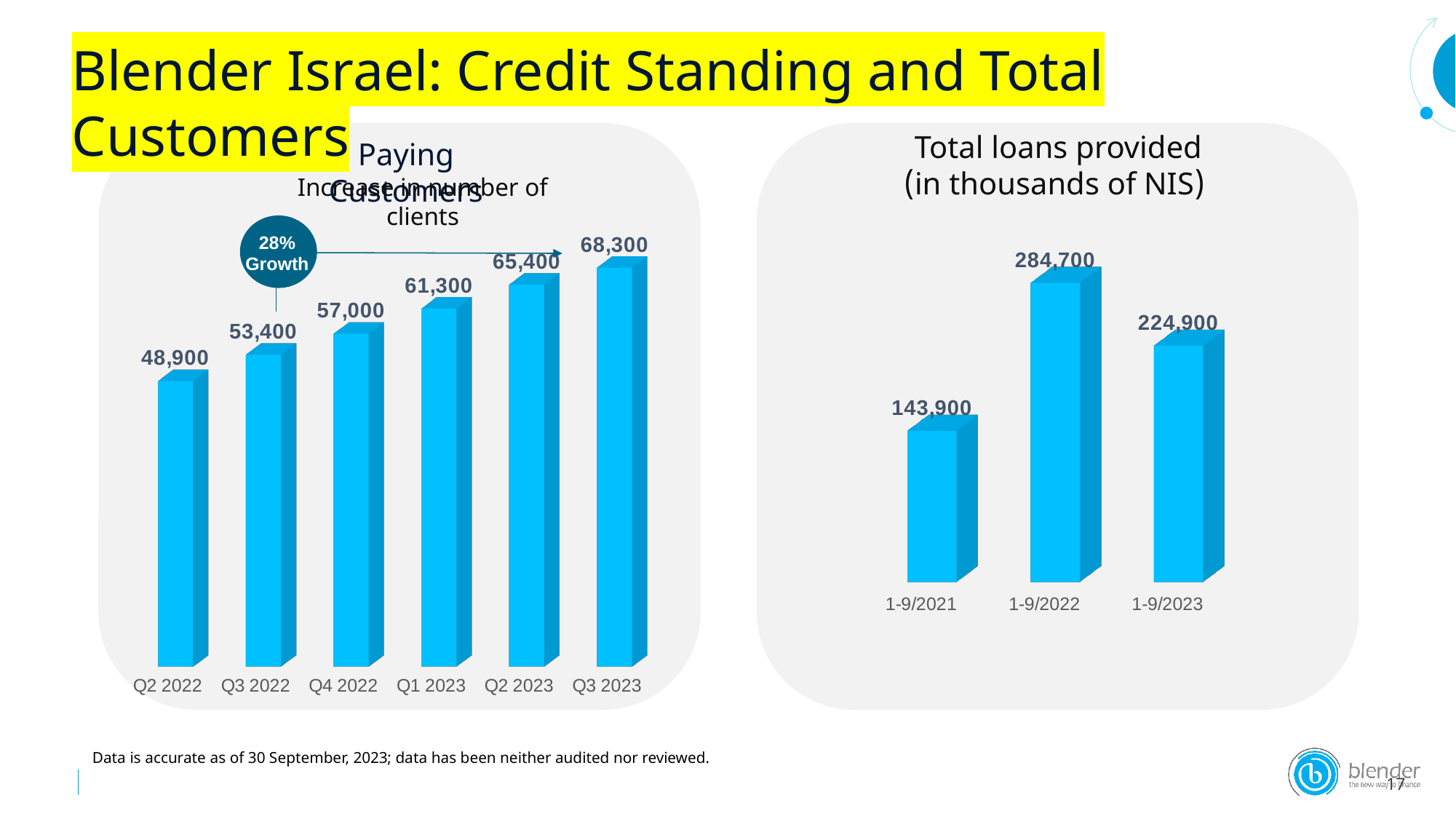
In the left chart (Paying Customers), what growth percentage is shown in the callout? 28% Growth In the 'Total loans provided' chart, which period has the highest value? 1-9/2022 In the 'Total loans provided' chart, what is the value for 1-9/2022? 284,700 In the left chart (Paying Customers), how many quarters are shown? 6 In the left chart (Paying Customers), what is the difference between Q3 2023 and Q2 2022? 19,400 What kind of chart is the 'Total loans provided' chart? bar chart In the left chart (Paying Customers), which quarter has the lowest value? Q2 2022 In the left chart (Paying Customers), what is the value for Q2 2022? 48,900 In the left chart (Paying Customers), do the values rise or fall from Q2 2022 to Q3 2023? rise In the 'Total loans provided' chart, what is the difference between 1-9/2022 and 1-9/2023? 59,800 In the left chart (Paying Customers), what is the value for Q3 2023? 68,300 In the 'Total loans provided' chart, which is larger: 1-9/2021 or 1-9/2023? 1-9/2023